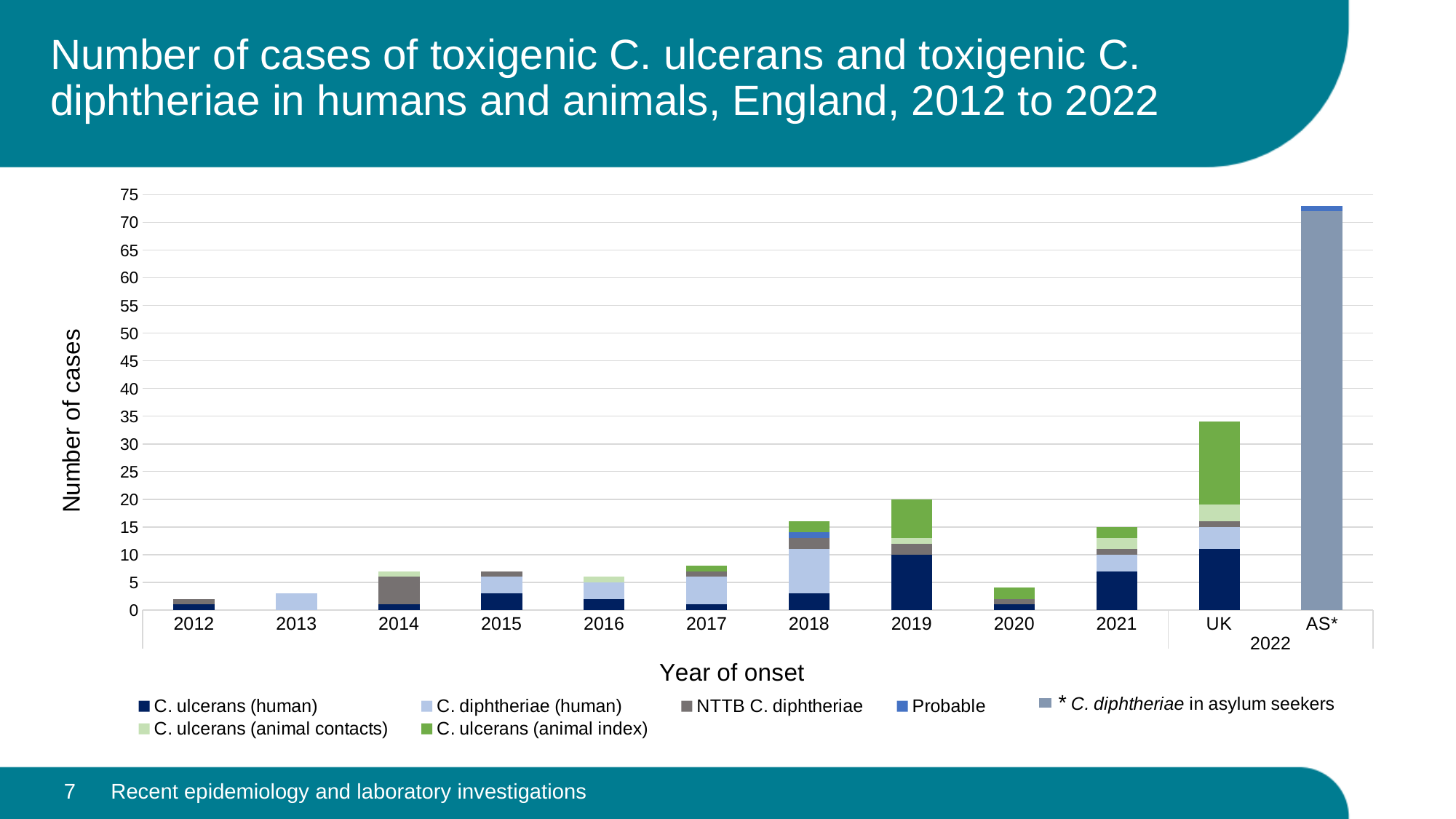
What is the label of the y axis? Number of cases Is the total for 2014 greater or less than 5? greater How many series does the legend list? 7 Which year has the lowest total number of cases? 2012 Which bar has the highest total number of cases? AS* 2022 How many bars are plotted along the x axis? 12 Is the total for AS* 2022 greater or less than 70? greater Do the total number of cases rise or fall from 2012 to 2014? rise Which has the larger total number of cases, 2018 or 2019? 2019 What kind of chart is shown on the slide? Stacked bar chart Is the total for UK 2022 greater or less than 30? greater